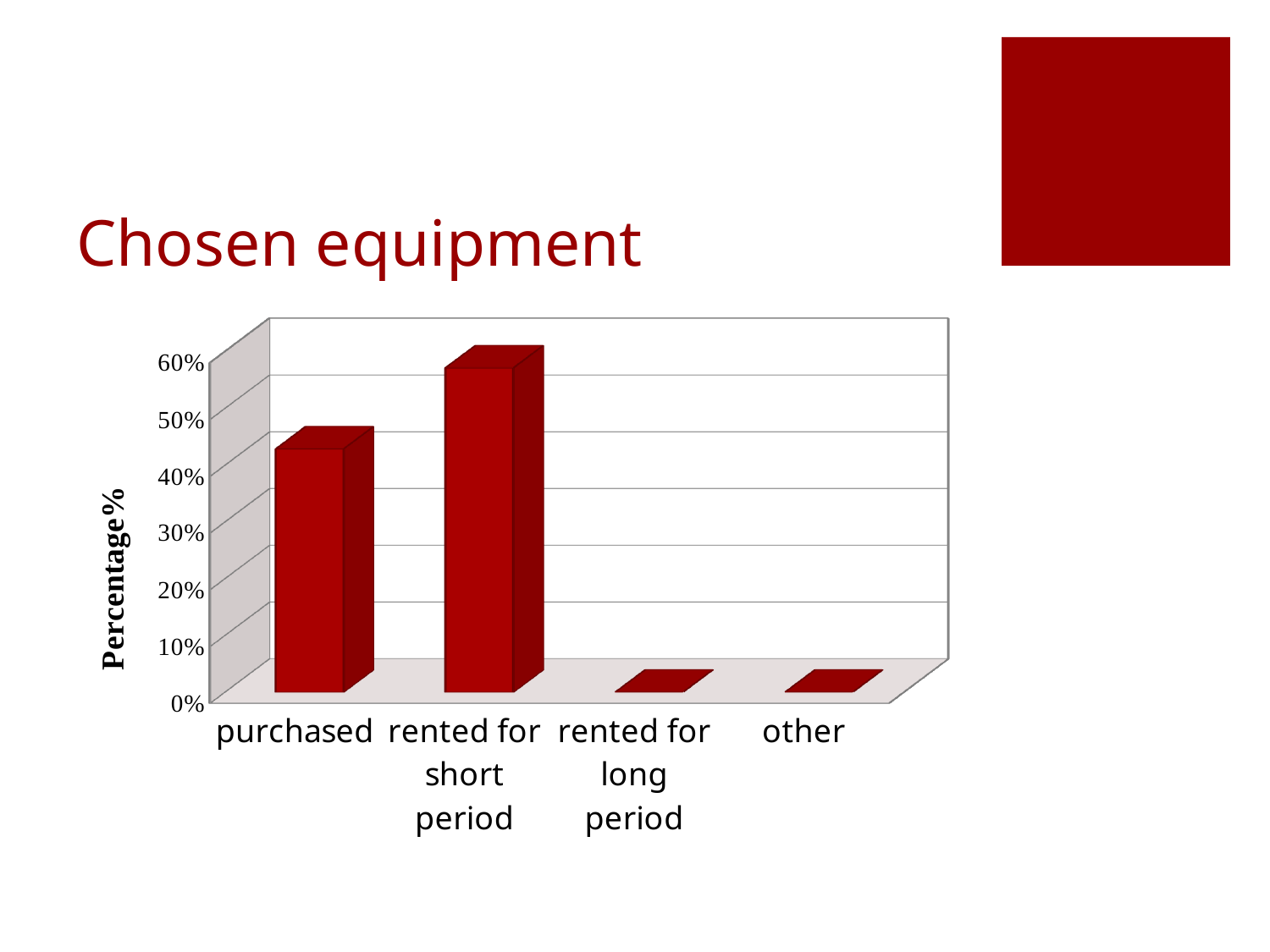
Is the value for rented for short period greater or less than 50%? greater What is the label on the vertical axis of the chart? Percentage% What is the title of the slide containing the chart? Chosen equipment How many categories are shown on the x axis of the chart? 4 Which is larger, the value for purchased or the value for other? purchased Is the value for rented for long period greater or less than 10%? less Is the value for purchased greater or less than 50%? less Which category has the highest value in the chart? rented for short period Which is larger, the value for purchased or the value for rented for short period? rented for short period What kind of chart is shown on the slide? bar chart